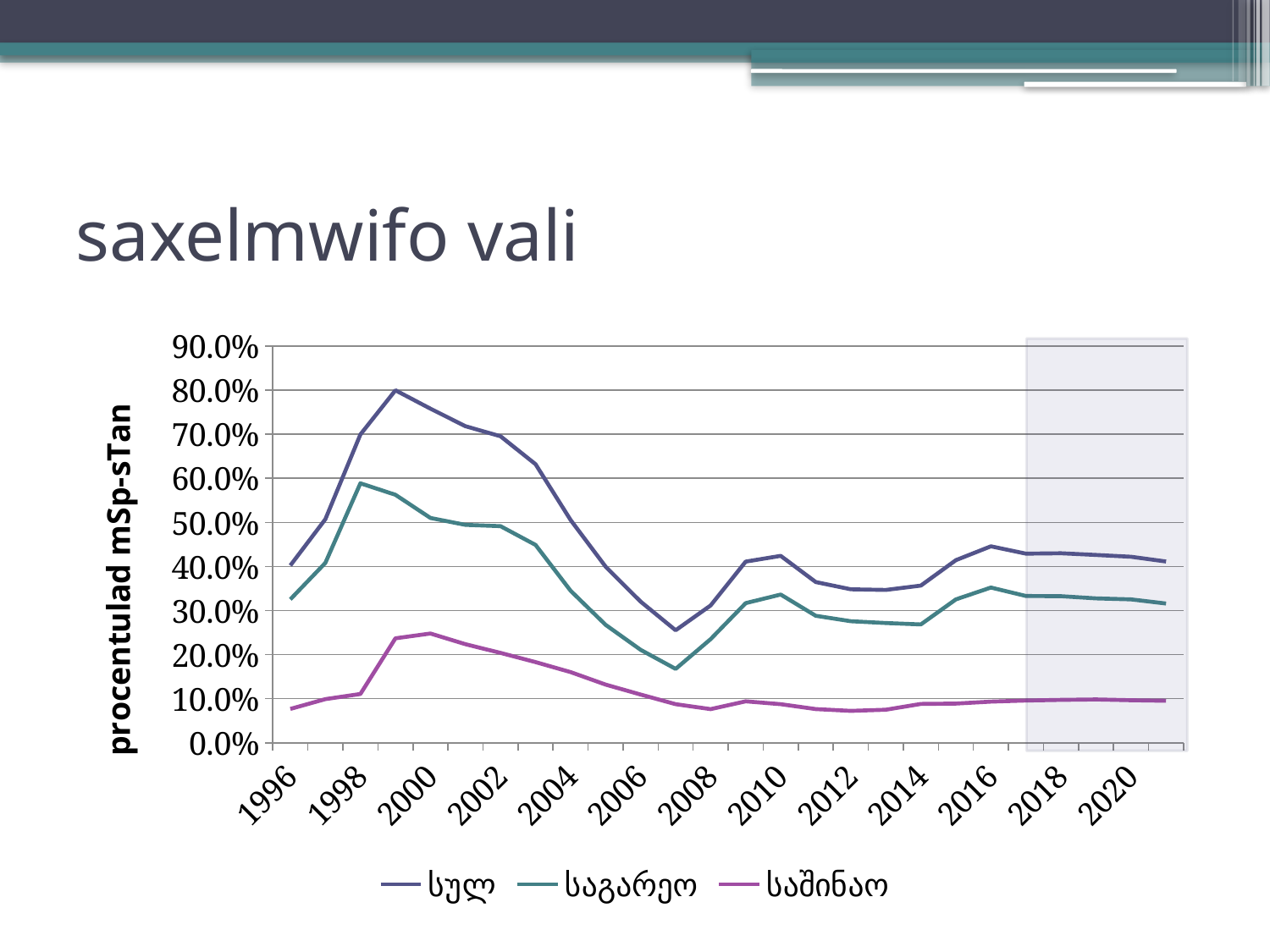
Does the სულ series rise or fall between 2000 and 2006? fall Which series has the highest values across the whole period? სულ Is the value of the საშინაო series in 2000 greater or less than 20.0%? greater Is the value of the სულ series in 2007 greater or less than 30.0%? less Is the peak value of the საგარეო series greater or less than 50.0%? greater Which series has the lowest values across the whole period? საშინაო What is the label of the vertical axis? procentulad mSp-sTan Which is larger for the სულ series: the value in 2000 or the value in 2010? 2000 How many series does the legend list? 3 What kind of chart is shown on the slide? line chart Which series is plotted with the purple/magenta line? საშინაო